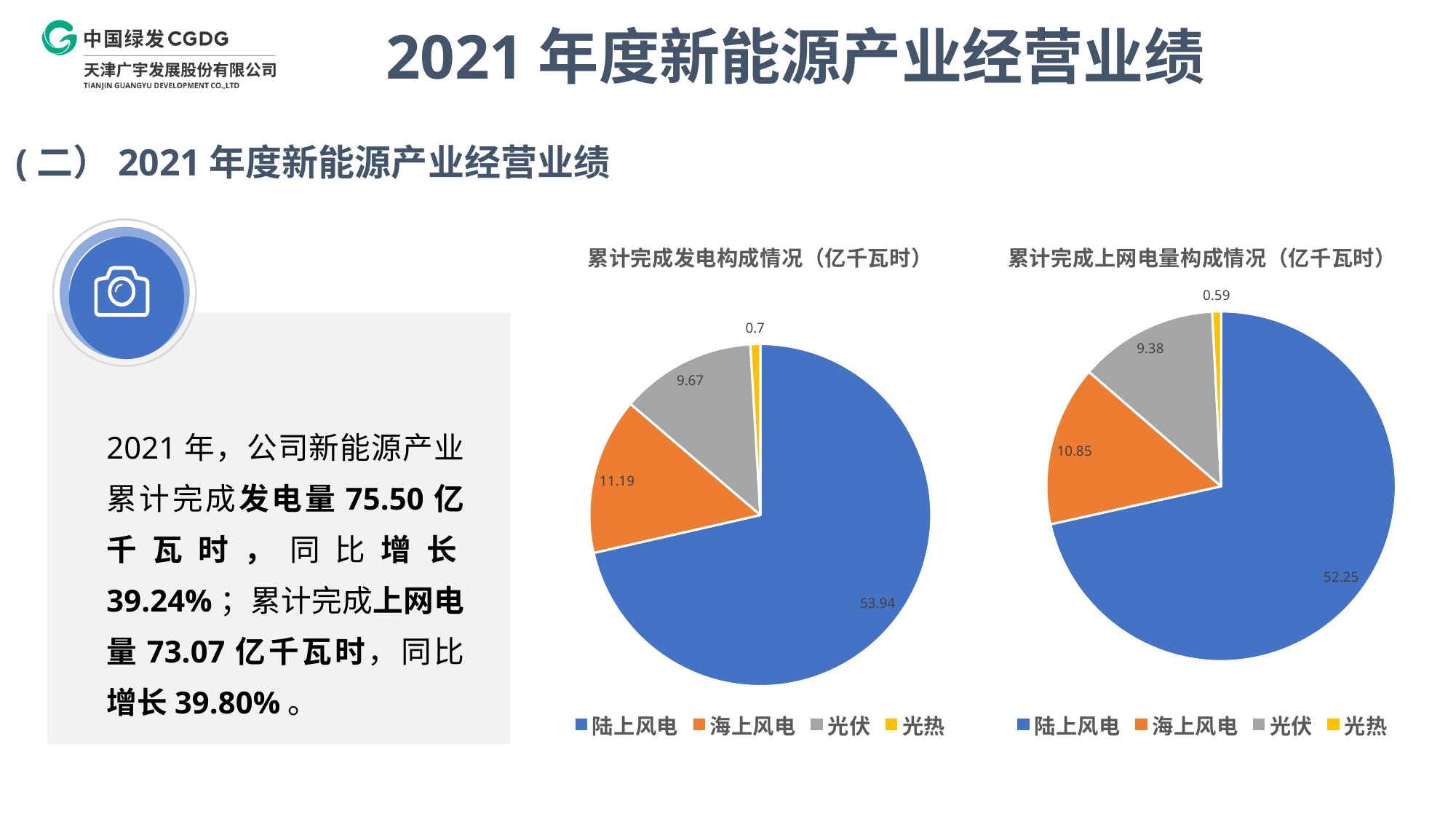
In the left pie chart (累计完成发电构成情况), what is the value for 陆上风电? 53.94 In the right pie chart (累计完成上网电量构成情况), what is the value for 光热? 0.59 In the left pie chart, which colour represents 海上风电? Orange In the right pie chart (累计完成上网电量构成情况), what is the value for 海上风电? 10.85 In the right pie chart (累计完成上网电量构成情况), which category has the smallest slice? 光热 Which is larger: 光伏 in the left pie chart or 光伏 in the right pie chart? Left pie chart (9.67) In the right pie chart (累计完成上网电量构成情况), what is the difference between 陆上风电 and 海上风电? 41.40 How many categories does the right pie chart (累计完成上网电量构成情况) show? 4 In the left pie chart (累计完成发电构成情况), what is the value for 光伏? 9.67 In the left pie chart (累计完成发电构成情况), what is the difference between 海上风电 and 光伏? 1.52 In the left pie chart (累计完成发电构成情况), which category has the largest slice? 陆上风电 What type of chart is used for 累计完成发电构成情况? Pie chart